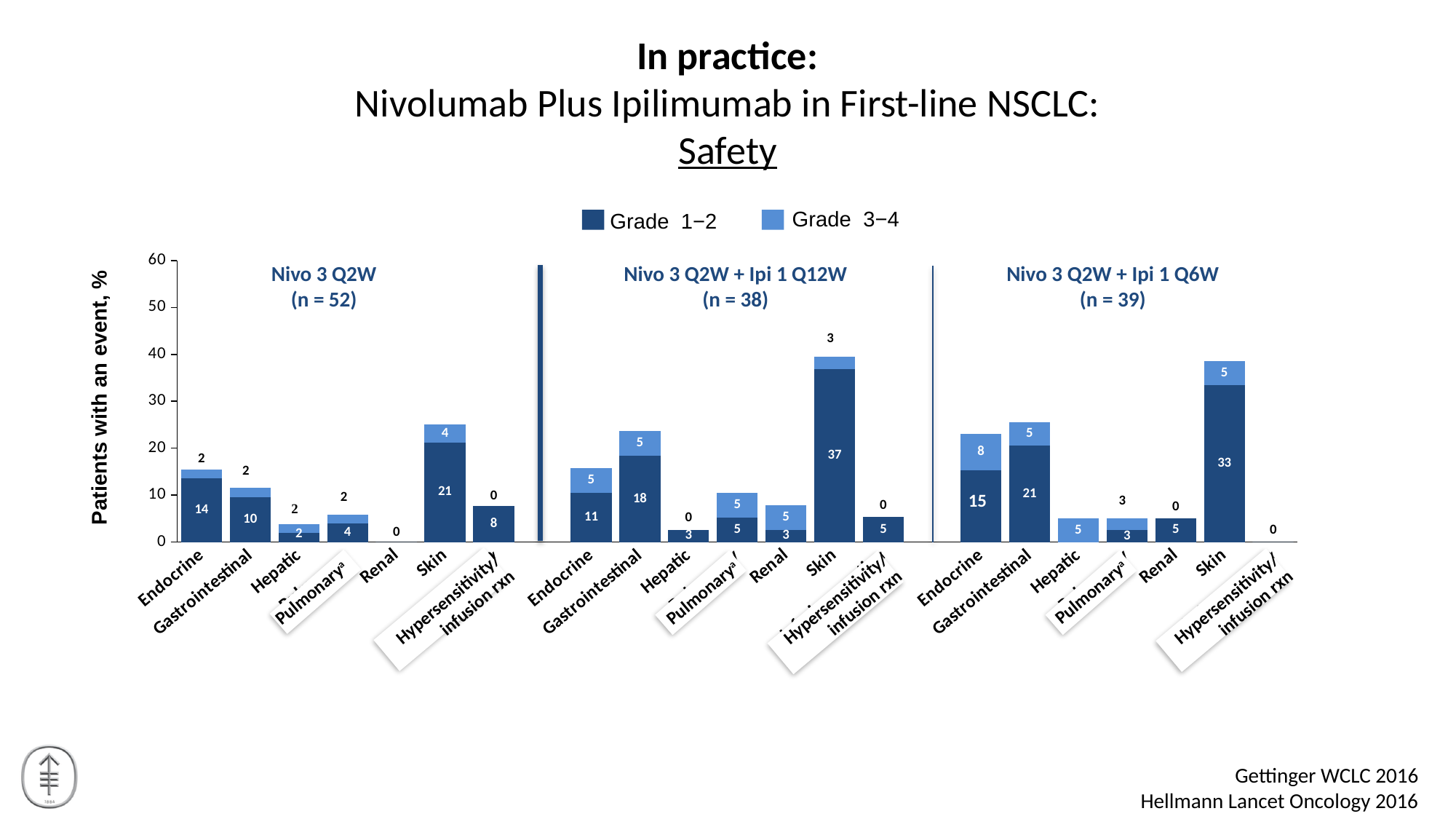
In the Nivo 3 Q2W + Ipi 1 Q12W (n = 38) panel, which category has the highest Grade 1−2 value? Skin What kind of chart is shown on the slide? Stacked bar chart What is the difference between the Grade 1−2 Skin value in the Nivo 3 Q2W + Ipi 1 Q12W panel and the Grade 1−2 Skin value in the Nivo 3 Q2W + Ipi 1 Q6W panel? 4 In the Nivo 3 Q2W (n = 52) panel, what is the Grade 1−2 value for Skin? 21 How many series does the legend list? 2 In the Nivo 3 Q2W + Ipi 1 Q6W (n = 39) panel, what is the Grade 3−4 value for Endocrine? 8 In the Nivo 3 Q2W + Ipi 1 Q12W (n = 38) panel, is the total Skin bar greater or less than 30? greater In the Nivo 3 Q2W + Ipi 1 Q12W (n = 38) panel, what is the Grade 3−4 value for Renal? 5 What is the label on the y axis of the chart? Patients with an event, % How many event categories are shown on the x axis of each treatment panel? 7 For Gastrointestinal Grade 1−2 events, which is larger: the Nivo 3 Q2W + Ipi 1 Q12W value or the Nivo 3 Q2W + Ipi 1 Q6W value? Nivo 3 Q2W + Ipi 1 Q6W In the Nivo 3 Q2W (n = 52) panel, what is the Grade 1−2 value for Hypersensitivity/infusion rxn? 8